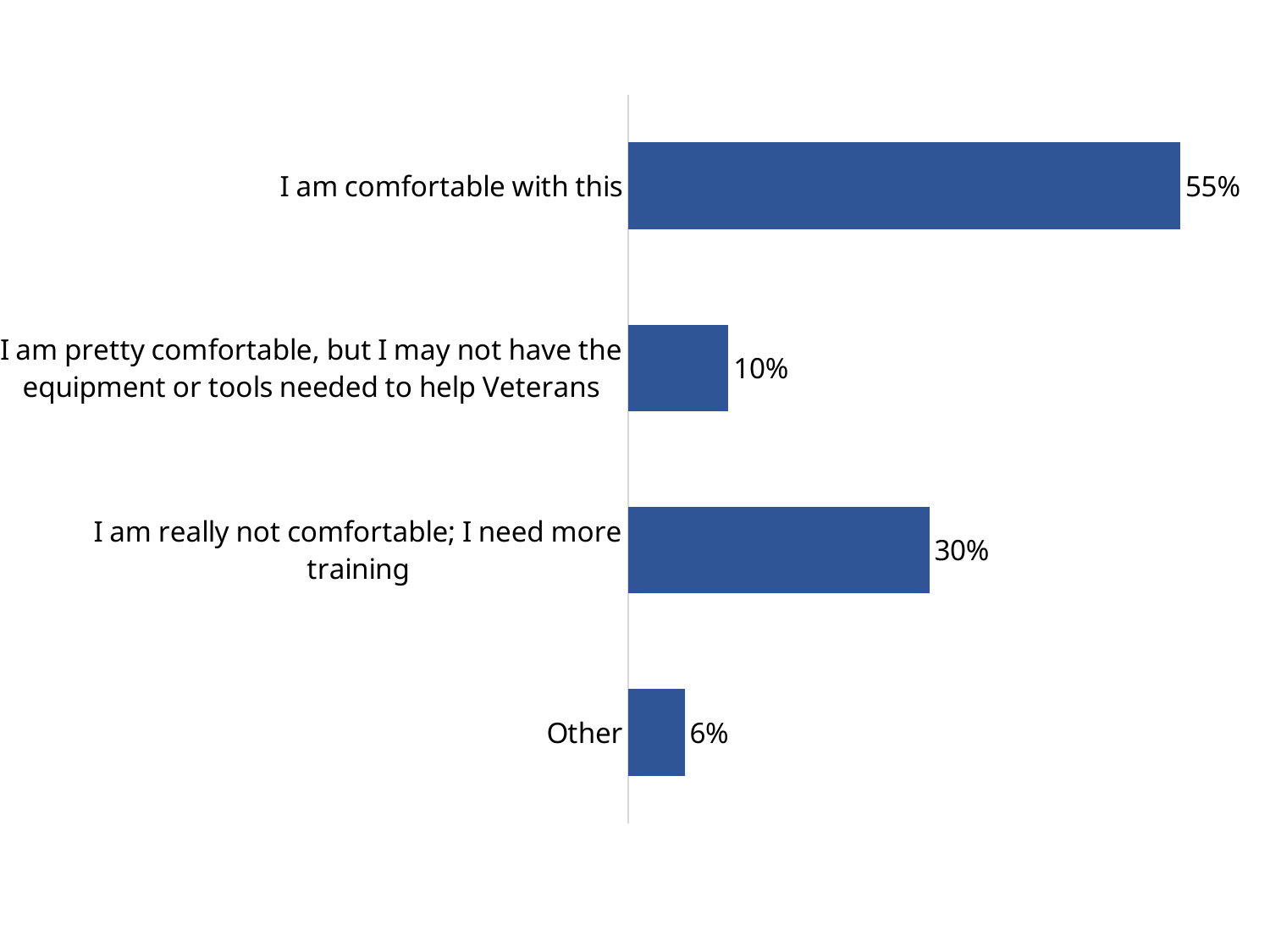
What colour are the bars in the chart? Blue What is the difference between "I am comfortable with this" and "I am really not comfortable; I need more training"? 25% What percentage of respondents said "I am comfortable with this"? 55% What is the difference between "I am pretty comfortable, but I may not have the equipment or tools needed to help Veterans" and "Other"? 4% Which category has the lowest value? Other What is the value for the "Other" category? 6% Which category has the highest value? I am comfortable with this What is the value for "I am really not comfortable; I need more training"? 30% What is the value for "I am pretty comfortable, but I may not have the equipment or tools needed to help Veterans"? 10% Which is larger: the value for "I am really not comfortable; I need more training" or the value for "I am pretty comfortable, but I may not have the equipment or tools needed to help Veterans"? I am really not comfortable; I need more training How many categories are shown in the chart? 4 What kind of chart is shown on the slide? Bar chart